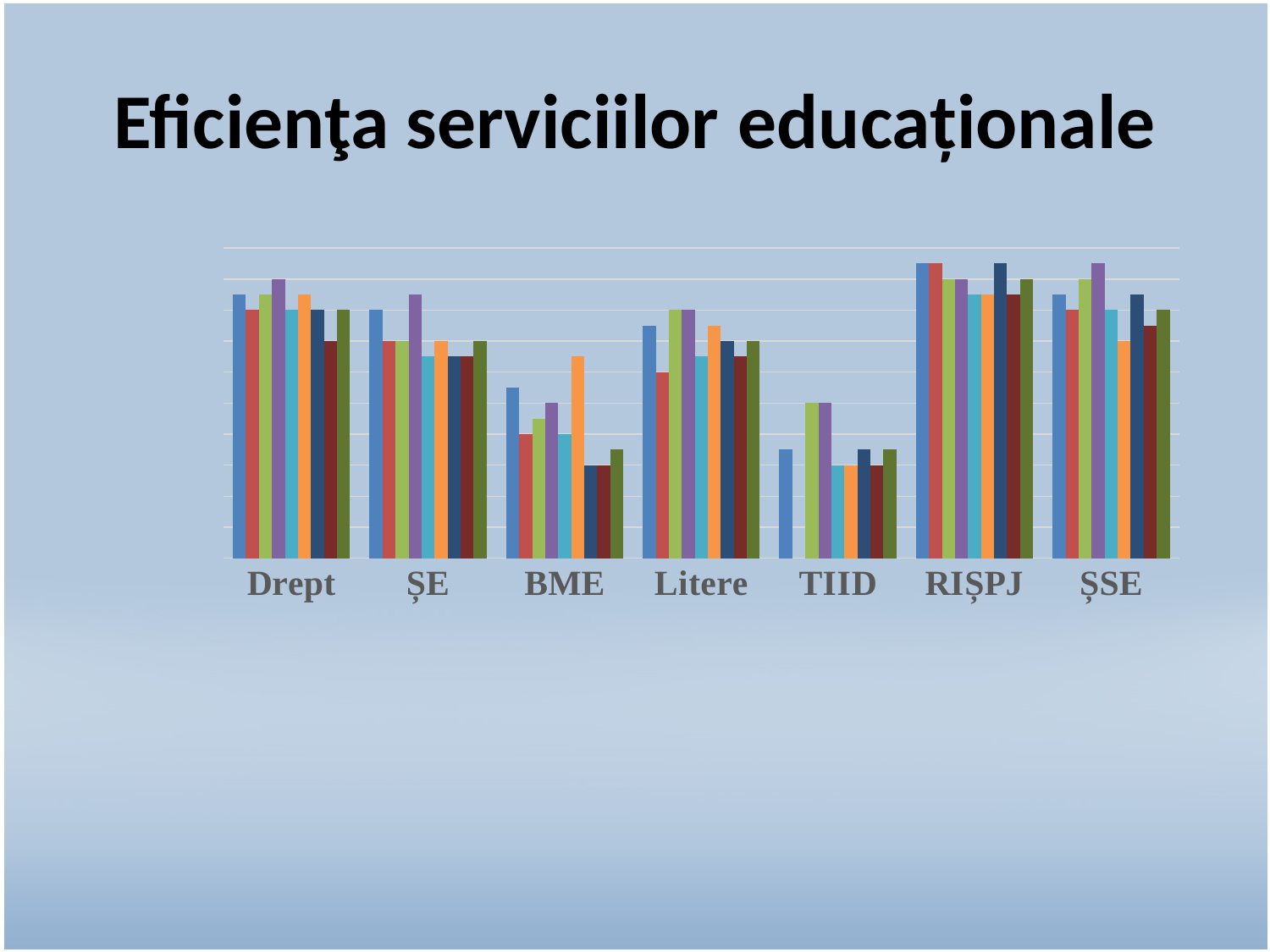
Is the purple bar taller for ȘSE or for Litere? ȘSE How many categories are shown on the x axis of the chart? 7 Does the chart display a legend? No Which category has the shortest blue (first) bar in the chart? TIID Is the blue (first) bar taller for RIȘPJ or for TIID? RIȘPJ What kind of chart is shown on the slide? bar chart What is the title of the slide containing the chart? Eficienţa serviciilor educaţionale Which category has the tallest bars overall in the chart? RIȘPJ Which category is listed first on the x axis? Drept Is the blue (first) bar taller for Drept or for BME? Drept Which category has the tallest blue (first) bar in the chart? RIȘPJ